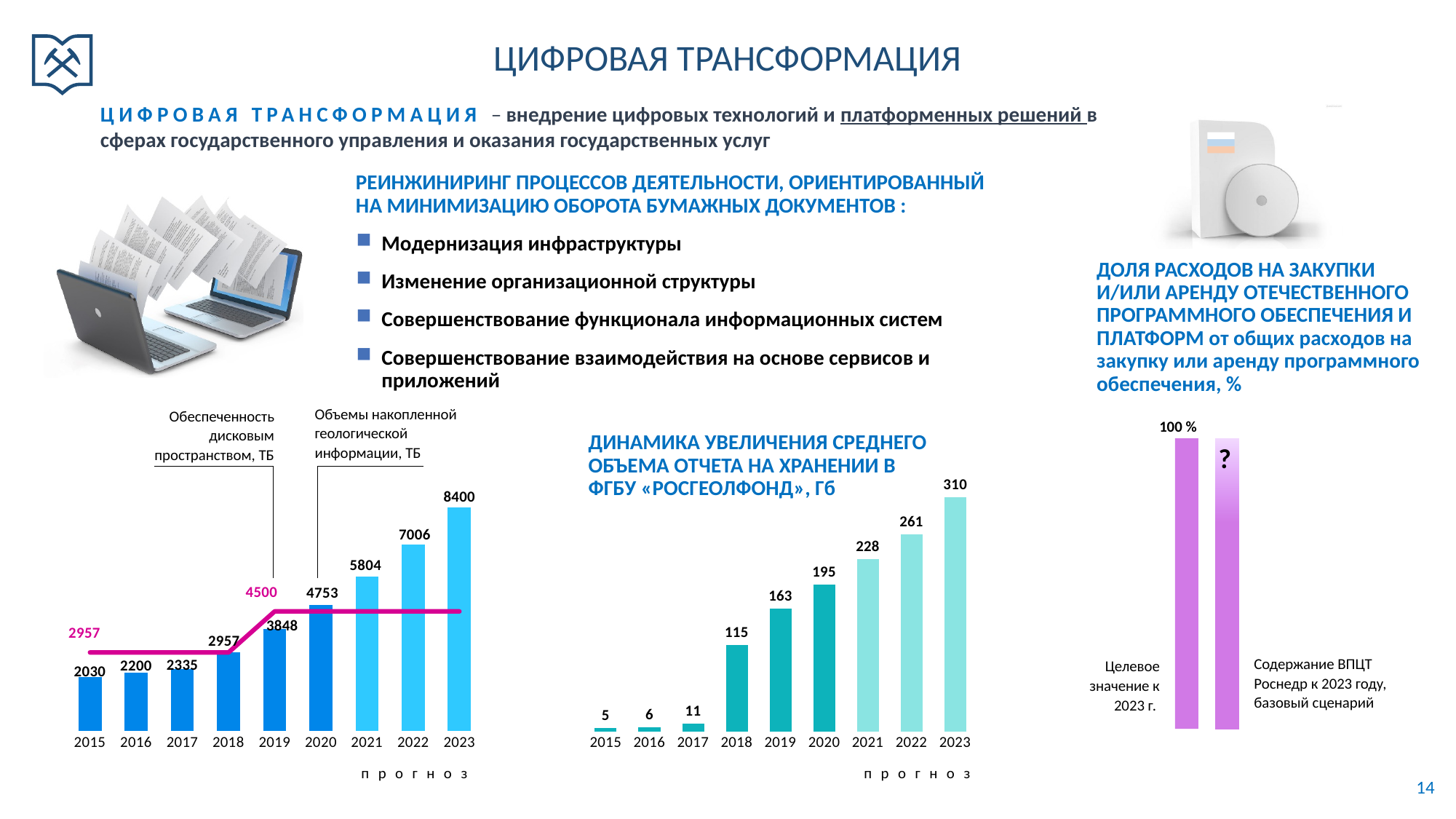
What kind of chart is the middle chart (ДИНАМИКА УВЕЛИЧЕНИЯ СРЕДНЕГО ОБЪЕМА ОТЧЕТА)? bar chart In the left chart, what is the value of Объемы накопленной геологической информации, ТБ for 2023? 8400 In the middle chart (ДИНАМИКА УВЕЛИЧЕНИЯ СРЕДНЕГО ОБЪЕМА ОТЧЕТА), which year has the lowest value? 2015 In the middle chart (ДИНАМИКА УВЕЛИЧЕНИЯ СРЕДНЕГО ОБЪЕМА ОТЧЕТА), how many years are shown on the x axis? 9 In the left chart, what value does the Обеспеченность дисковым пространством, ТБ line reach from 2019 onward? 4500 In the middle chart (ДИНАМИКА УВЕЛИЧЕНИЯ СРЕДНЕГО ОБЪЕМА ОТЧЕТА НА ХРАНЕНИИ В ФГБУ «РОСГЕОЛФОНД», Гб), what is the value for 2020? 195 In the left chart, which is larger in 2020: Объемы накопленной геологической информации or Обеспеченность дисковым пространством? Объемы накопленной геологической информации In the middle chart (ДИНАМИКА УВЕЛИЧЕНИЯ СРЕДНЕГО ОБЪЕМА ОТЧЕТА), what is the difference between the values for 2023 and 2022? 49 In the middle chart (ДИНАМИКА УВЕЛИЧЕНИЯ СРЕДНЕГО ОБЪЕМА ОТЧЕТА), which year has the highest value? 2023 In the middle chart (ДИНАМИКА УВЕЛИЧЕНИЯ СРЕДНЕГО ОБЪЕМА ОТЧЕТА), do the values rise or fall from 2015 to 2023? rise In the left chart, what is the difference between the Объемы накопленной геологической информации values for 2023 and 2022? 1394 In the left chart, what is the value of Объемы накопленной геологической информации, ТБ for 2019? 3848